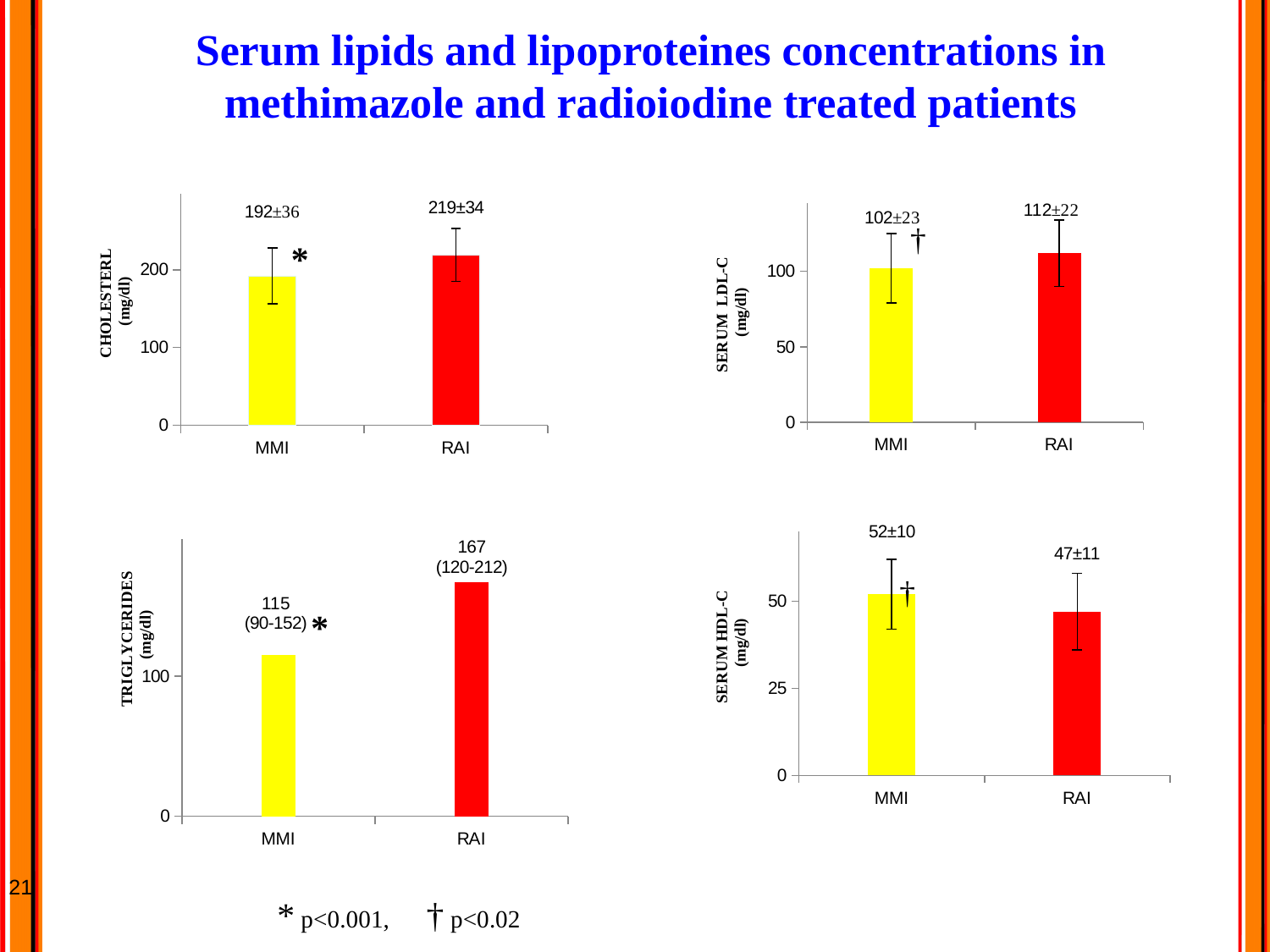
In the serum HDL-C chart (bottom right), which group has the lower HDL-C value? RAI In the cholesterol chart (top left), what is the difference between the RAI and MMI mean cholesterol values? 27 What type of chart is used for the triglycerides data (bottom left)? Bar chart In the serum LDL-C chart (top right), what value is labelled for the RAI bar? 112±22 In the cholesterol chart (top left), what value is labelled for the MMI bar? 192±36 In the triglycerides chart (bottom left), what median value is labelled for the MMI bar? 115 In the serum HDL-C chart (bottom right), what value is labelled for the MMI bar? 52±10 How many bars are plotted in the serum LDL-C chart (top right)? 2 In the serum LDL-C chart (top right), which group has the higher LDL-C value, MMI or RAI? RAI In the cholesterol chart (top left), what value is labelled for the RAI bar? 219±34 In the triglycerides chart (bottom left), what is the difference between the RAI and MMI median values? 52 In the triglycerides chart (bottom left), what range is given in parentheses for the RAI bar? (120-212)